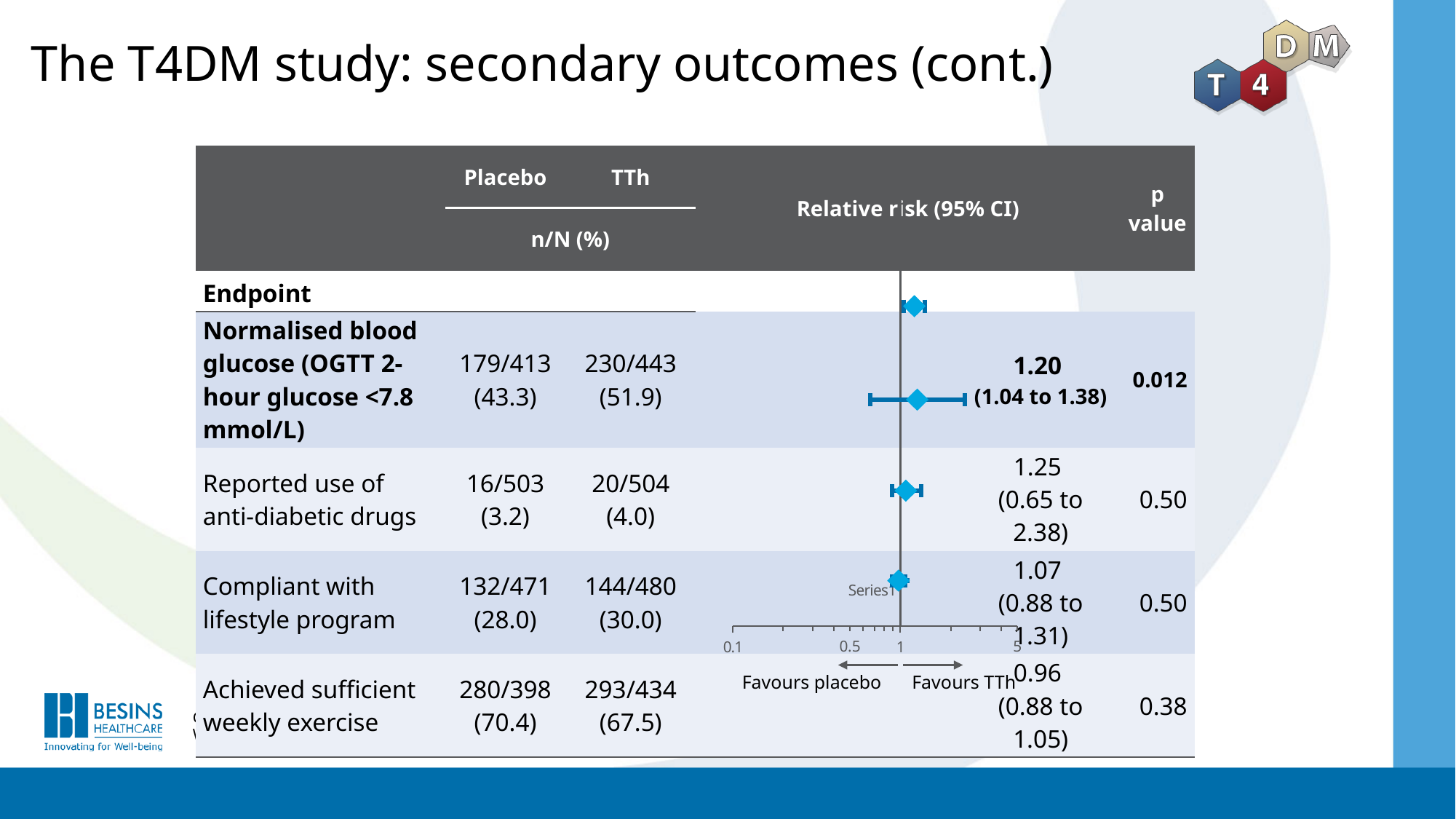
Is the relative risk for normalised blood glucose greater or less than 1? greater What is the difference between the relative risk for reported use of anti-diabetic drugs and for normalised blood glucose? 0.05 How many endpoints are plotted in the forest plot? 4 What is the relative risk for normalised blood glucose (OGTT 2-hour glucose <7.8 mmol/L)? 1.20 What is the relative risk for achieved sufficient weekly exercise? 0.96 What kind of chart is shown in the Relative risk (95% CI) column? Forest plot What is the 95% CI for the relative risk of reported use of anti-diabetic drugs? 0.65 to 2.38 Which has the larger relative risk: normalised blood glucose or compliant with lifestyle program? Normalised blood glucose Which endpoint has the lowest relative risk? Achieved sufficient weekly exercise What does the right-pointing arrow below the x axis of the forest plot indicate? Favours TTh What is the p value for the normalised blood glucose endpoint? 0.012 Which endpoint has the highest relative risk? Reported use of anti-diabetic drugs